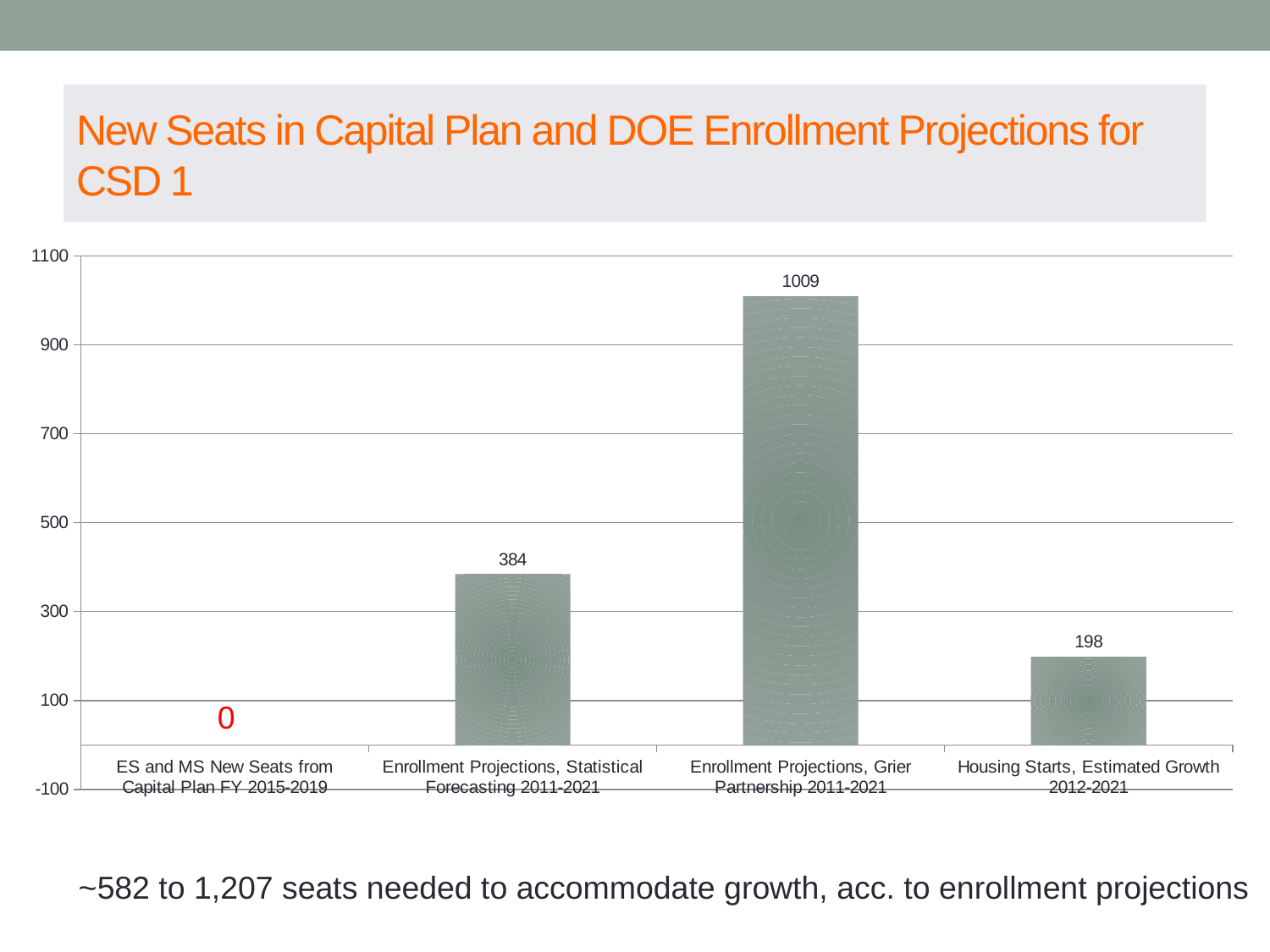
Is the value for Enrollment Projections, Grier Partnership 2011-2021 greater or less than 900? greater What is the value for ES and MS New Seats from Capital Plan FY 2015-2019? 0 How many categories are shown on the chart? 4 What is the value for Enrollment Projections, Statistical Forecasting 2011-2021? 384 Which category has the lowest value? ES and MS New Seats from Capital Plan FY 2015-2019 Which is larger, the value for Housing Starts, Estimated Growth 2012-2021 or the value for Enrollment Projections, Statistical Forecasting 2011-2021? Enrollment Projections, Statistical Forecasting 2011-2021 Which category has the highest value? Enrollment Projections, Grier Partnership 2011-2021 What is the difference between the Statistical Forecasting projection and the Housing Starts estimated growth? 186 What is the difference between the Grier Partnership projection and the Statistical Forecasting projection? 625 What is the value for Enrollment Projections, Grier Partnership 2011-2021? 1009 What is the value for Housing Starts, Estimated Growth 2012-2021? 198 What kind of chart is shown on the slide? Bar chart